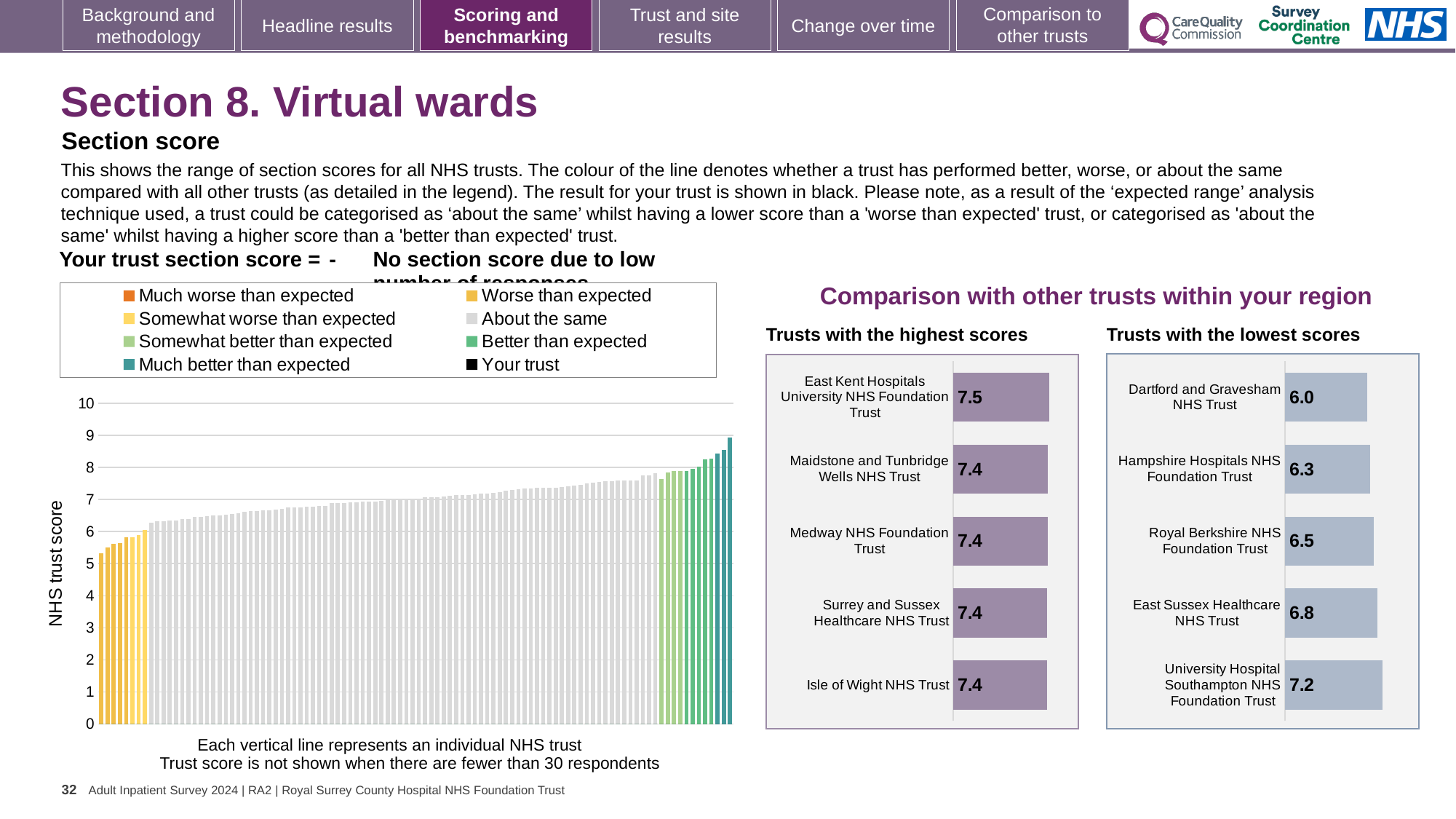
In the 'Trusts with the highest scores' chart, which trust has the highest score? East Kent Hospitals University NHS Foundation Trust What is the y-axis label of the large chart on the left? NHS trust score In the 'Trusts with the lowest scores' chart, which has the higher score: Royal Berkshire NHS Foundation Trust or Hampshire Hospitals NHS Foundation Trust? Royal Berkshire NHS Foundation Trust In the 'Trusts with the highest scores' chart, what is the score for East Kent Hospitals University NHS Foundation Trust? 7.5 In the 'Trusts with the lowest scores' chart, what is the difference between the scores of University Hospital Southampton NHS Foundation Trust and Dartford and Gravesham NHS Trust? 1.2 How many trusts are shown in the 'Trusts with the highest scores' chart? 5 In the large 'NHS trust score' chart on the left, do the bar values rise or fall from left to right? Rise In the 'Trusts with the lowest scores' chart, which trust has the lowest score? Dartford and Gravesham NHS Trust What type of chart is the large 'NHS trust score' chart on the left? Bar chart In the 'Trusts with the lowest scores' chart, what is the score for Dartford and Gravesham NHS Trust? 6.0 In the large 'NHS trust score' chart on the left, is the value of the rightmost bar greater or less than 8? greater How many entries does the legend of the large 'NHS trust score' chart on the left list? 8